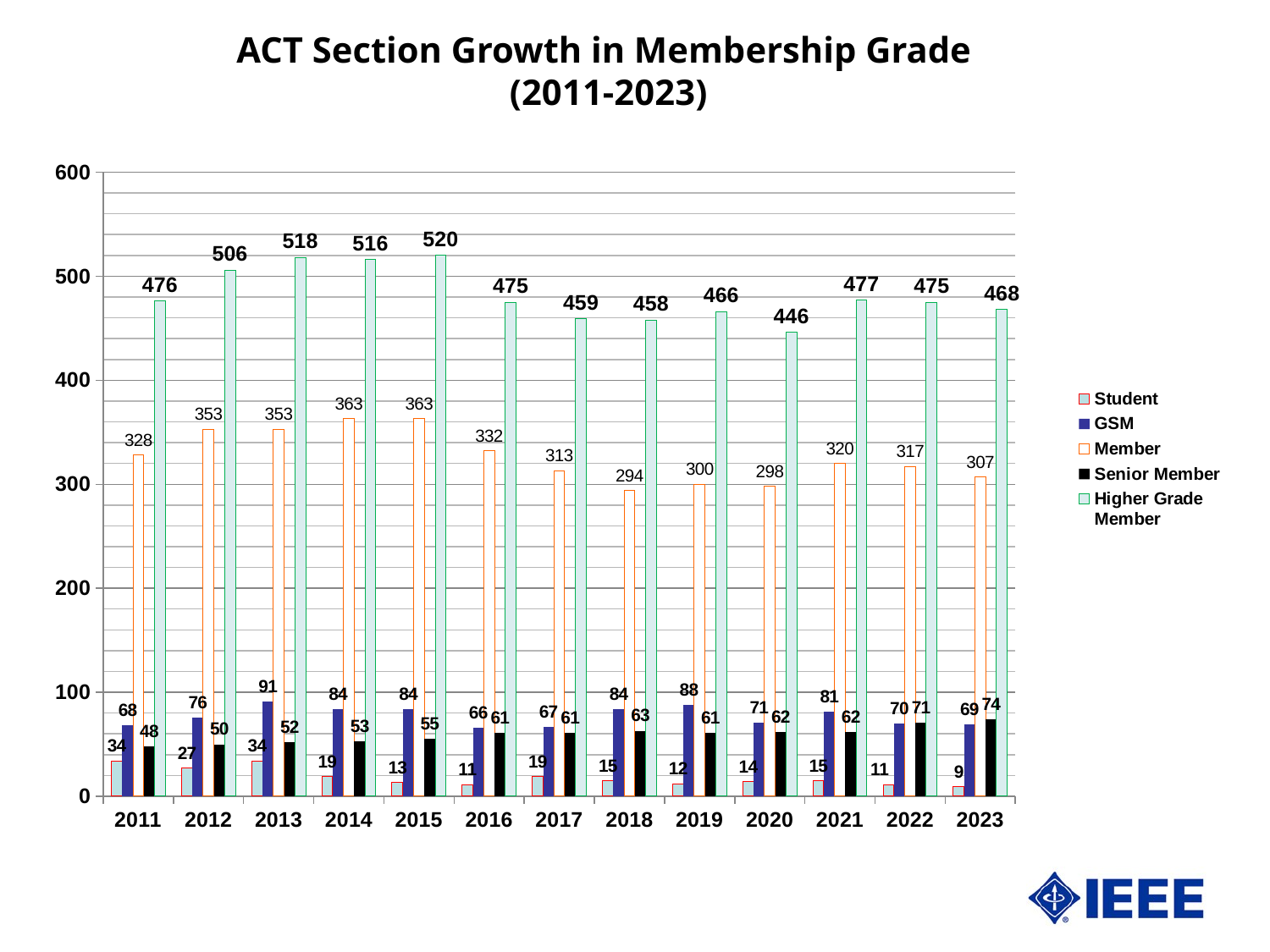
What is the difference between the Higher Grade Member values for 2015 and 2020? 74 What kind of chart is shown on the slide? bar chart In which year is the Student value lowest? 2023 Does the Senior Member value rise or fall from 2011 to 2023? rise How many series does the legend list? 5 What is the Senior Member value for 2023? 74 Is the Member value for 2011 greater or less than 300? greater What is the Member value for 2018? 294 In which year is the GSM value highest? 2013 How many years are shown on the x axis? 13 What is the Higher Grade Member value for 2015? 520 Which is larger, the Member value for 2014 or the Member value for 2023? 2014